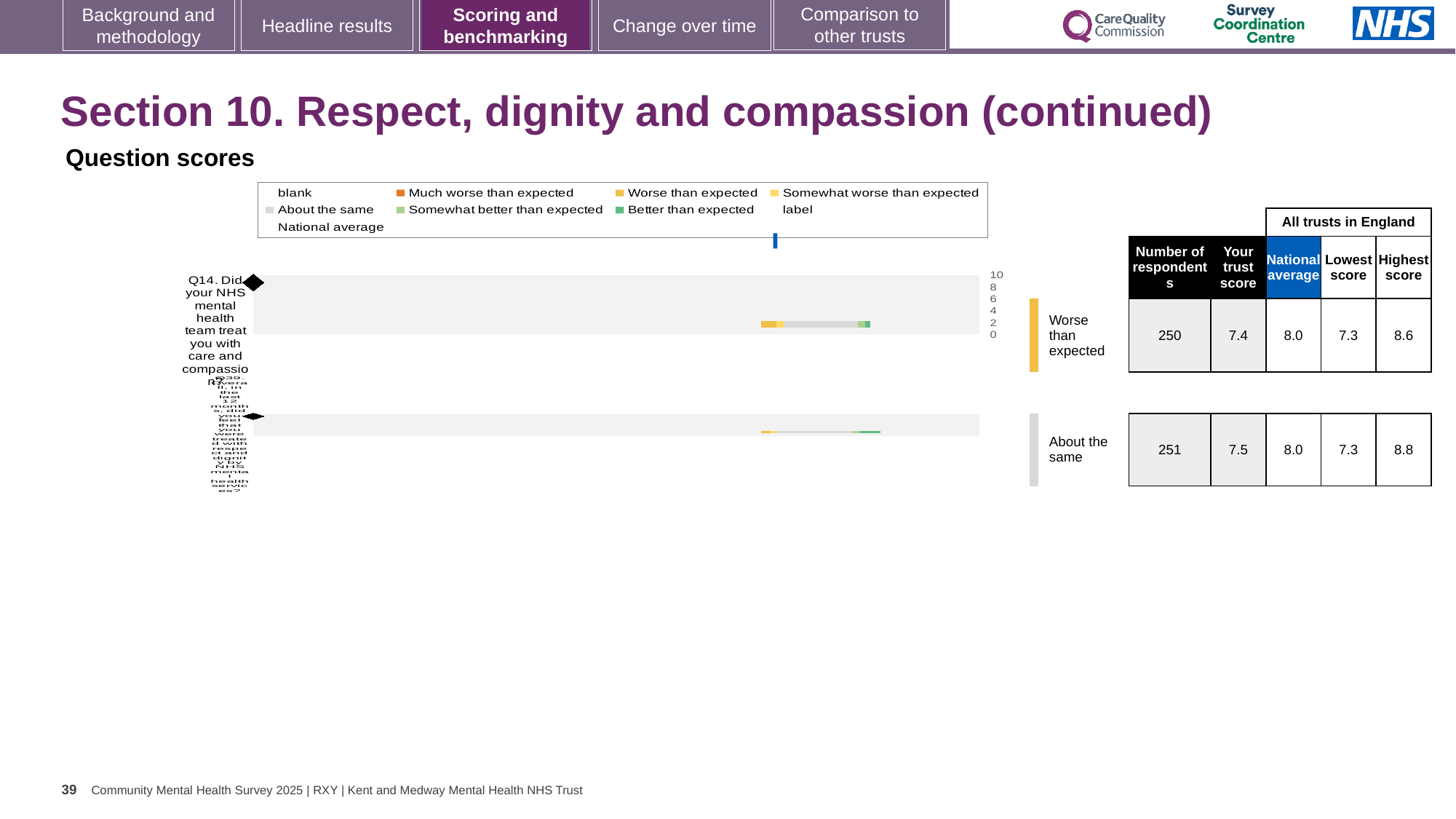
What benchmark category is shown for Q14 in the question scores chart? Worse than expected What kind of chart is used to show the question scores on this slide? bar chart What is the highest score among all trusts in England for Q14? 8.6 What is the trust's score for Q14 (Did your NHS mental health team treat you with care and compassion?)? 7.4 What is the national average score for Q14? 8.0 What is the number of respondents for Q14 (Did your NHS mental health team treat you with care and compassion?)? 250 How many questions are plotted in the question scores chart? 2 How many entries does the legend of the question scores chart list? 9 Which question has the higher trust score, Q14 or the second question row (Q39)? Q39 What is the highest score among all trusts in England for the second question row (Q39)? 8.8 What is the trust's score for the second question row (Q39)? 7.5 What is the difference between the highest score in England and the trust's score for Q14? 1.2